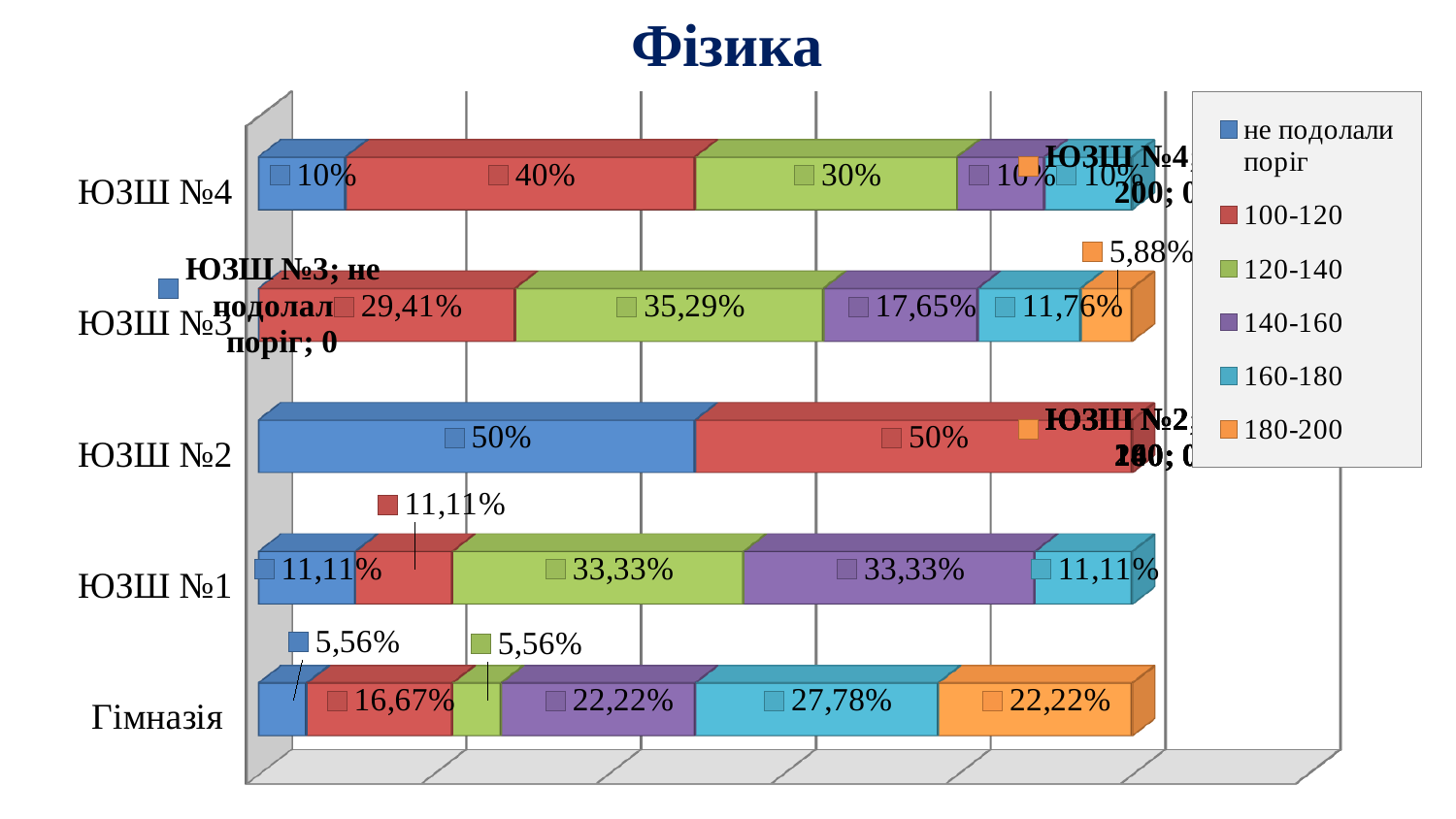
What is the value of the 'не подолали поріг' series for ЮЗШ №2? 50% How many series does the legend list? 6 Which category has the highest value for the 'не подолали поріг' series? ЮЗШ №2 How many categories (schools) are shown on the chart? 5 What is the value of the 100-120 series for ЮЗШ №4? 40% What is the value of the 120-140 series for ЮЗШ №3? 35,29% Which is larger for Гімназія: the 140-160 value or the 100-120 value? 140-160 What is the difference between the 120-140 value and the 160-180 value for ЮЗШ №1? 22,22% What is the title of the chart? Фізика What is the value of the 160-180 series for Гімназія? 27,78% What kind of chart is shown on the slide? stacked bar chart What is the value of the 180-200 series for ЮЗШ №3? 5,88%